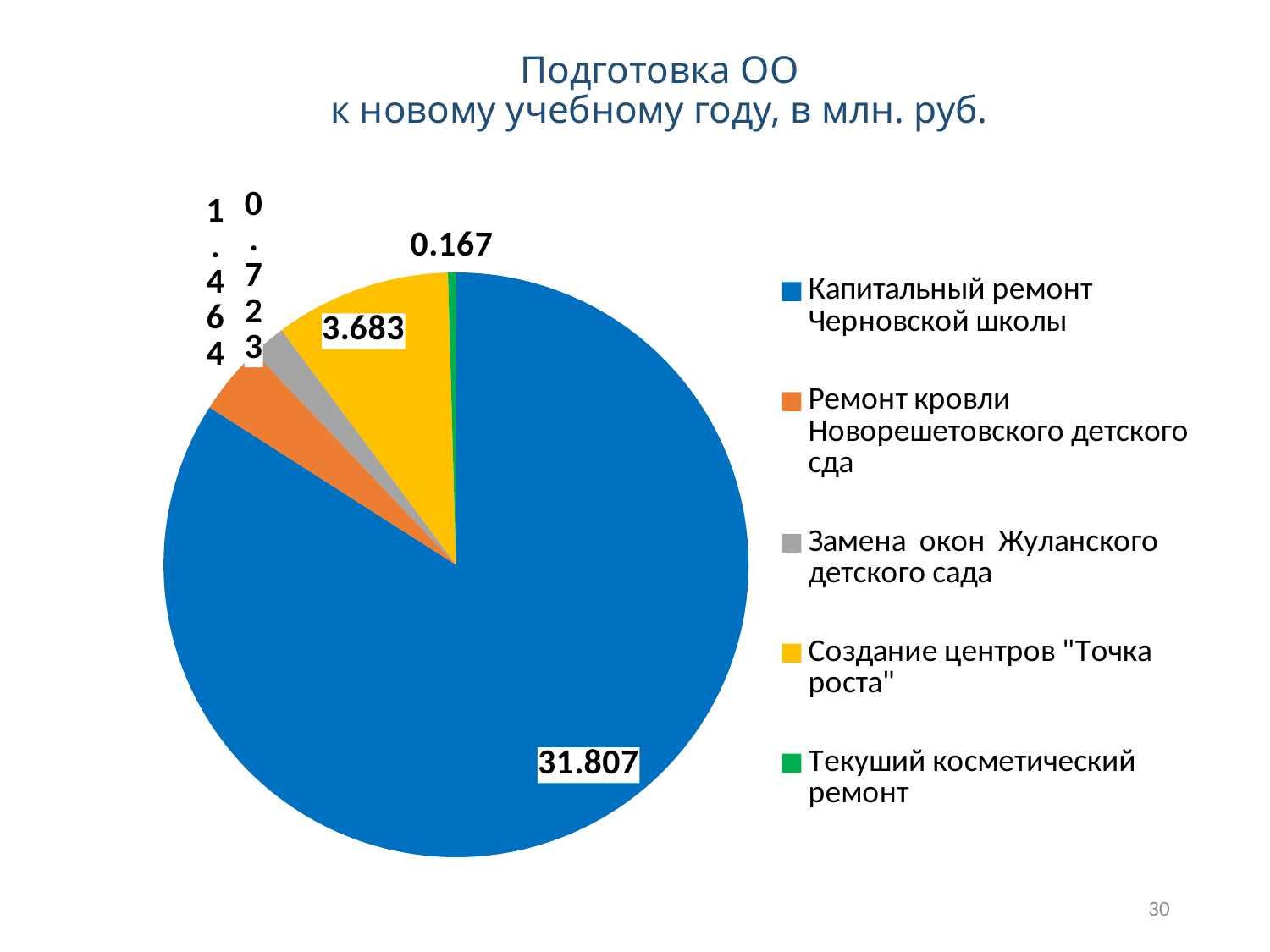
How many slices does the pie chart have? 5 Which category has the smallest slice of the pie? Текуший косметический ремонт What unit is stated in the chart title? млн. руб. What is the value for Текуший косметический ремонт? 0.167 Which category has the largest slice of the pie? Капитальный ремонт Черновской школы What is the difference between the values for Капитальный ремонт Черновской школы and Создание центров "Точка роста"? 28.124 Which is larger: Создание центров "Точка роста" or Ремонт кровли Новорешетовского детского сда? Создание центров "Точка роста" What is the value for Создание центров "Точка роста"? 3.683 What is the value for Замена окон Жуланского детского сада? 0.723 What type of chart is shown on the slide? pie chart What is the value for Ремонт кровли Новорешетовского детского сда? 1.464 What is the value for Капитальный ремонт Черновской школы? 31.807